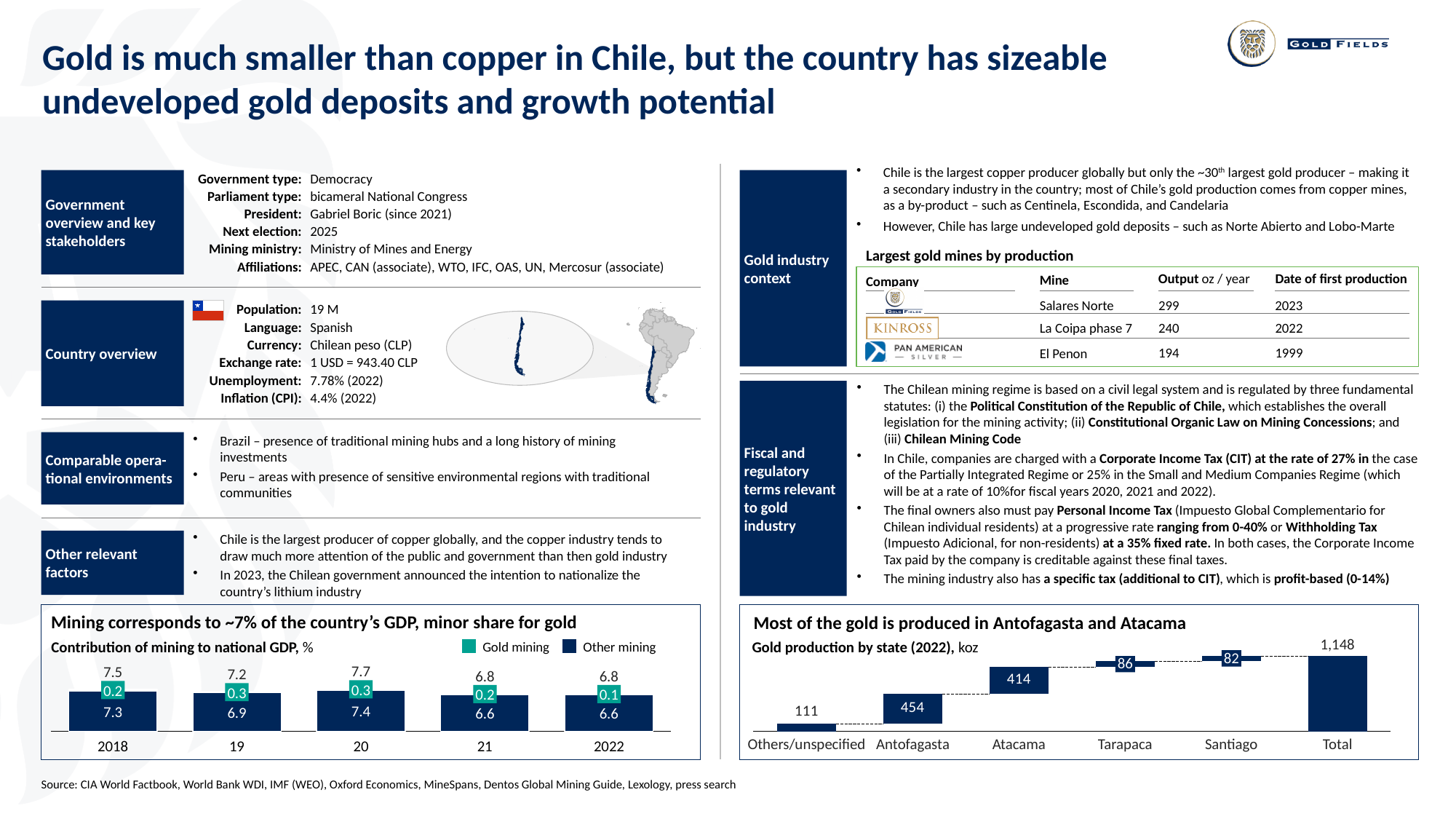
What kind of chart is the 'Gold production by state (2022)' chart? Bar chart (waterfall) In the 'Gold production by state (2022)' chart, which state has the lowest gold production? Santiago In the 'Gold production by state (2022)' chart, what is the total gold production? 1,148 In the 'Contribution of mining to national GDP' chart, how many series does the legend list? 2 In the 'Contribution of mining to national GDP' chart, what is the total contribution of mining in 2018? 7.5 In the 'Gold production by state (2022)' chart, which is larger, Tarapaca or Others/unspecified? Others/unspecified In the 'Contribution of mining to national GDP' chart, which year has the highest total contribution of mining? 2020 In the 'Contribution of mining to national GDP' chart, what is the value for Gold mining in 2022? 0.1 In the 'Gold production by state (2022)' chart, what is the value for Antofagasta? 454 In the 'Gold production by state (2022)' chart, what is the difference between Antofagasta and Atacama? 40 In the 'Contribution of mining to national GDP' chart, what is the difference between the Other mining values for 2020 and 2021? 0.8 In the 'Contribution of mining to national GDP' chart, what is the value for Other mining in 2020? 7.4